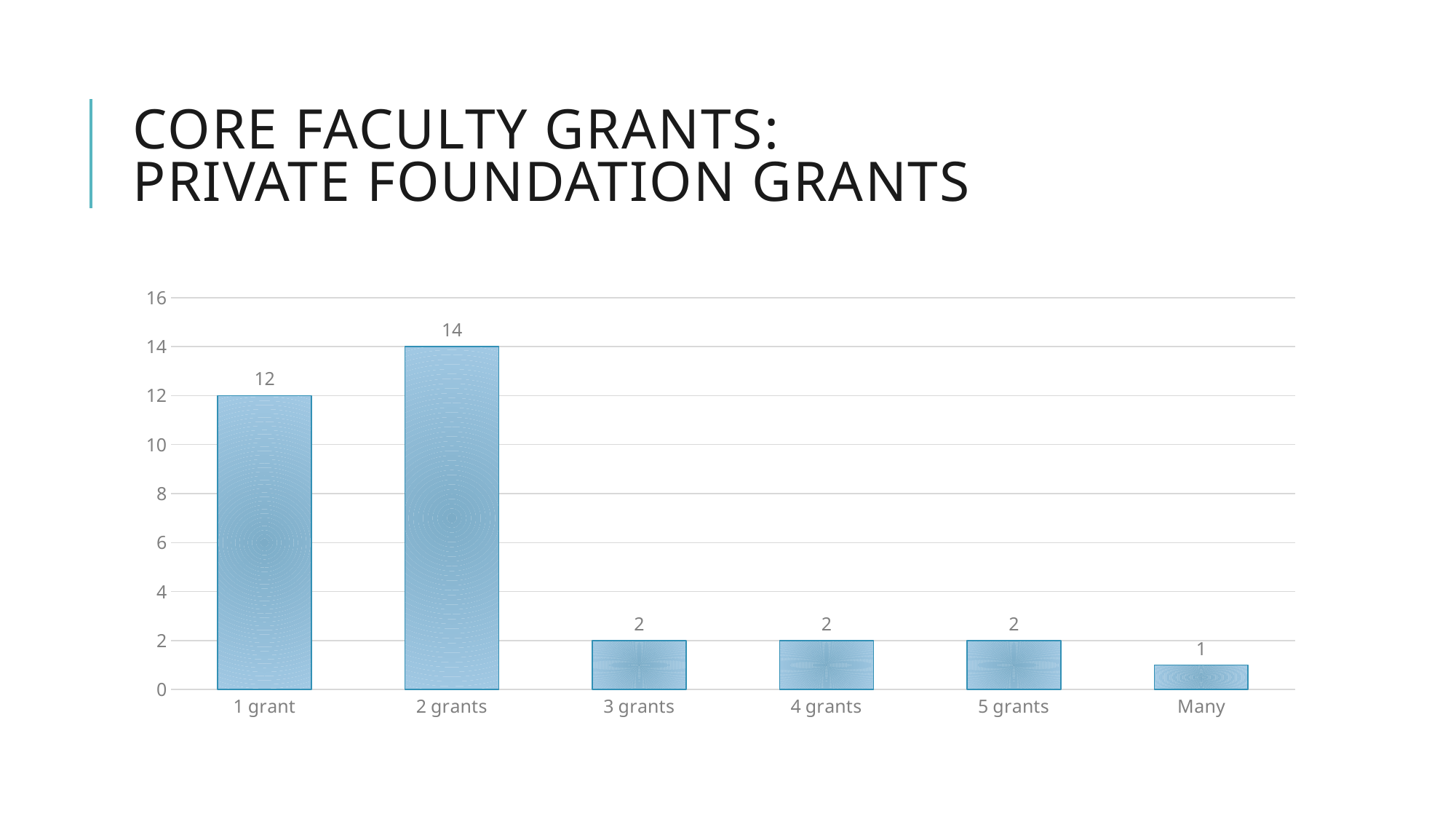
What is the value for the '1 grant' category? 12 Which category has the highest value? 2 grants What kind of chart is shown on the slide? Bar chart What is the difference between the values for '1 grant' and '3 grants'? 10 What is the title of the slide? Core Faculty Grants: Private Foundation Grants Which is larger, the value for '1 grant' or the value for '2 grants'? 2 grants What is the difference between the values for '2 grants' and '1 grant'? 2 How many categories are shown on the x axis? 6 What is the value for the '4 grants' category? 2 Which category has the lowest value? Many What is the value for the 'Many' category? 1 What is the value for the '2 grants' category? 14